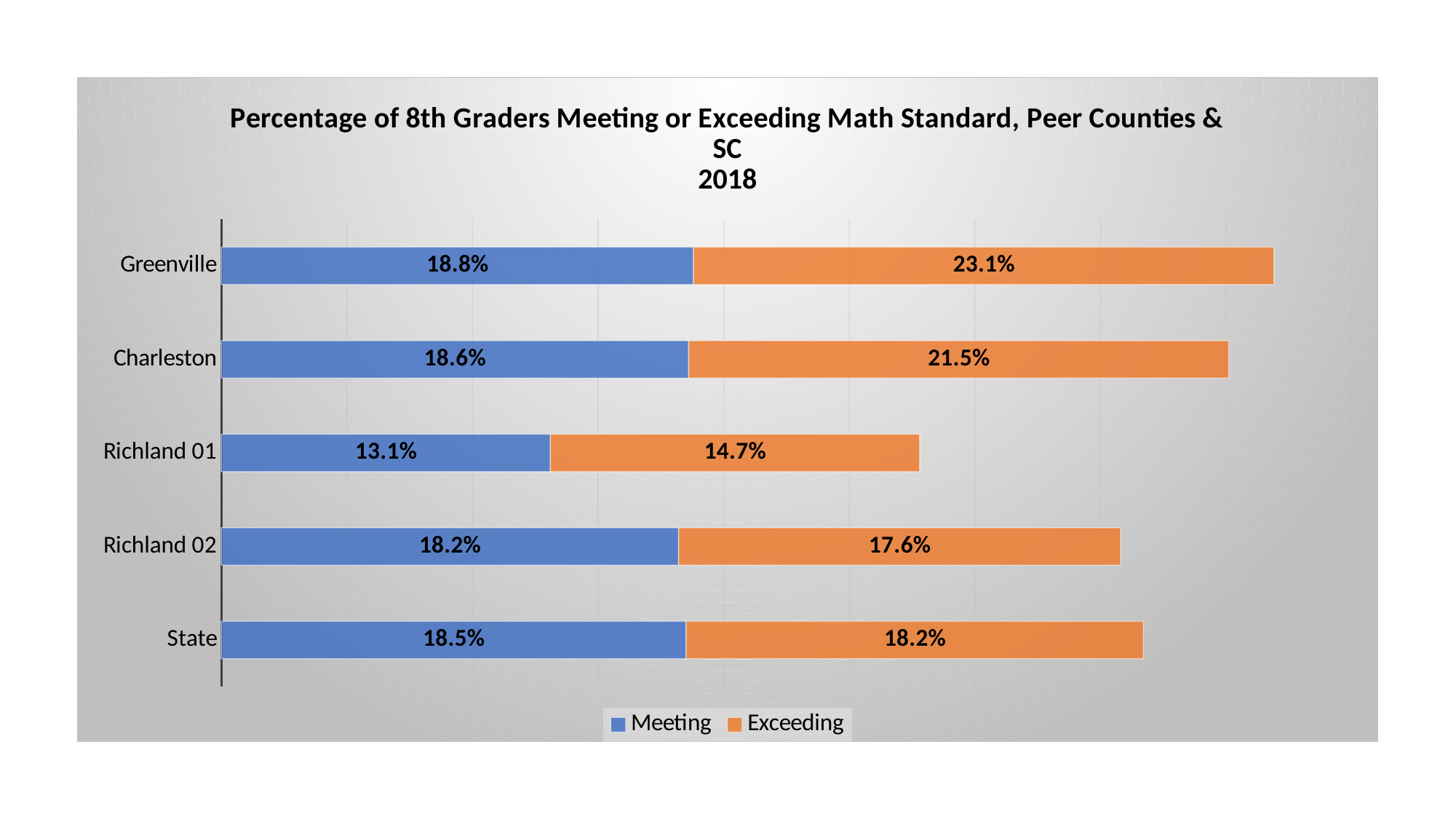
What is the combined Meeting and Exceeding total for Richland 01? 27.8% What is the Meeting value for Richland 01? 13.1% Which category has the lowest Meeting value? Richland 01 Which category has the highest Exceeding value? Greenville What kind of chart is shown on the slide? Stacked bar chart How many categories are shown on the chart? 5 How many series does the legend list? 2 What percentage of 8th graders in Greenville are Exceeding the math standard? 23.1% What is the difference between the Exceeding values for Greenville and Charleston? 1.6% What is the Exceeding value for the State? 18.2% Which is larger for Richland 02: the Meeting value or the Exceeding value? Meeting What is the combined Meeting and Exceeding total for Greenville? 41.9%